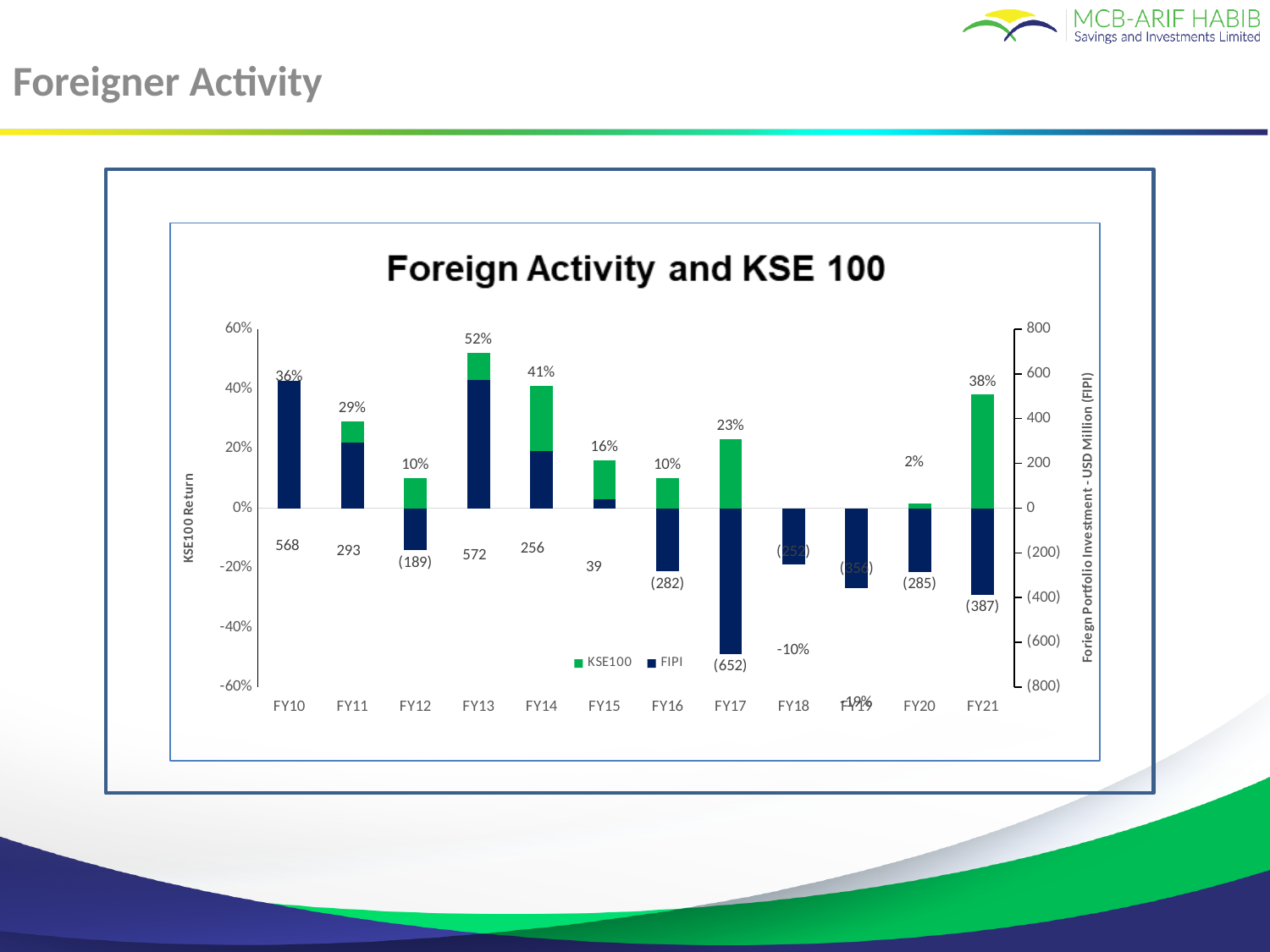
What is the FIPI value for FY15? 39 What is the difference between the KSE100 return in FY13 and FY14? 11% How many series does the legend list in the 'Foreign Activity and KSE 100' chart? 2 Which fiscal year has the lowest FIPI value? FY17 Which fiscal year has the larger FIPI value, FY10 or FY13? FY13 Which fiscal year has the highest KSE100 return? FY13 What is the title of the chart? Foreign Activity and KSE 100 What is the KSE100 return for FY21? 38% What is the KSE100 return for FY13? 52% What is the FIPI value for FY17? (652) How many fiscal years are shown on the x axis of the chart? 12 What kind of chart is shown on the slide? bar chart